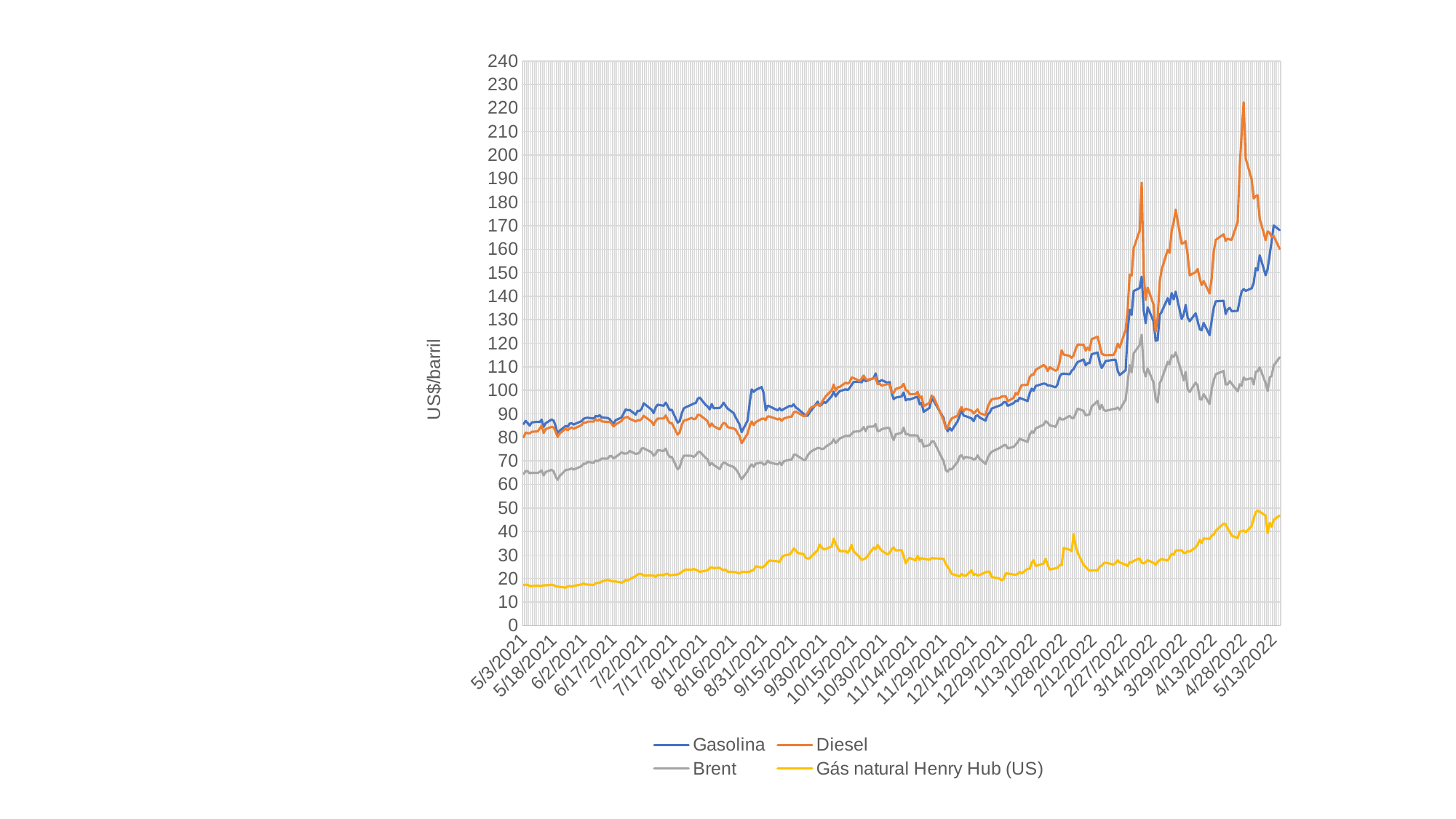
At 5/13/2022, which is larger, Gasolina or Brent? Gasolina How many series does the legend list? 4 Is the value for Gás natural Henry Hub (US) at 5/3/2021 greater or less than 20? less Is the value for Brent at 5/13/2022 greater or less than 100? greater Is the value for Brent at 5/3/2021 greater or less than 70? less Does the Gás natural Henry Hub (US) series rise or fall overall from 5/3/2021 to 5/13/2022? rise What kind of chart is shown on the slide? line chart Which series stays lowest across the whole period? Gás natural Henry Hub (US) Which series reaches the highest value anywhere on the chart? Diesel What is the label on the vertical axis? US$/barril